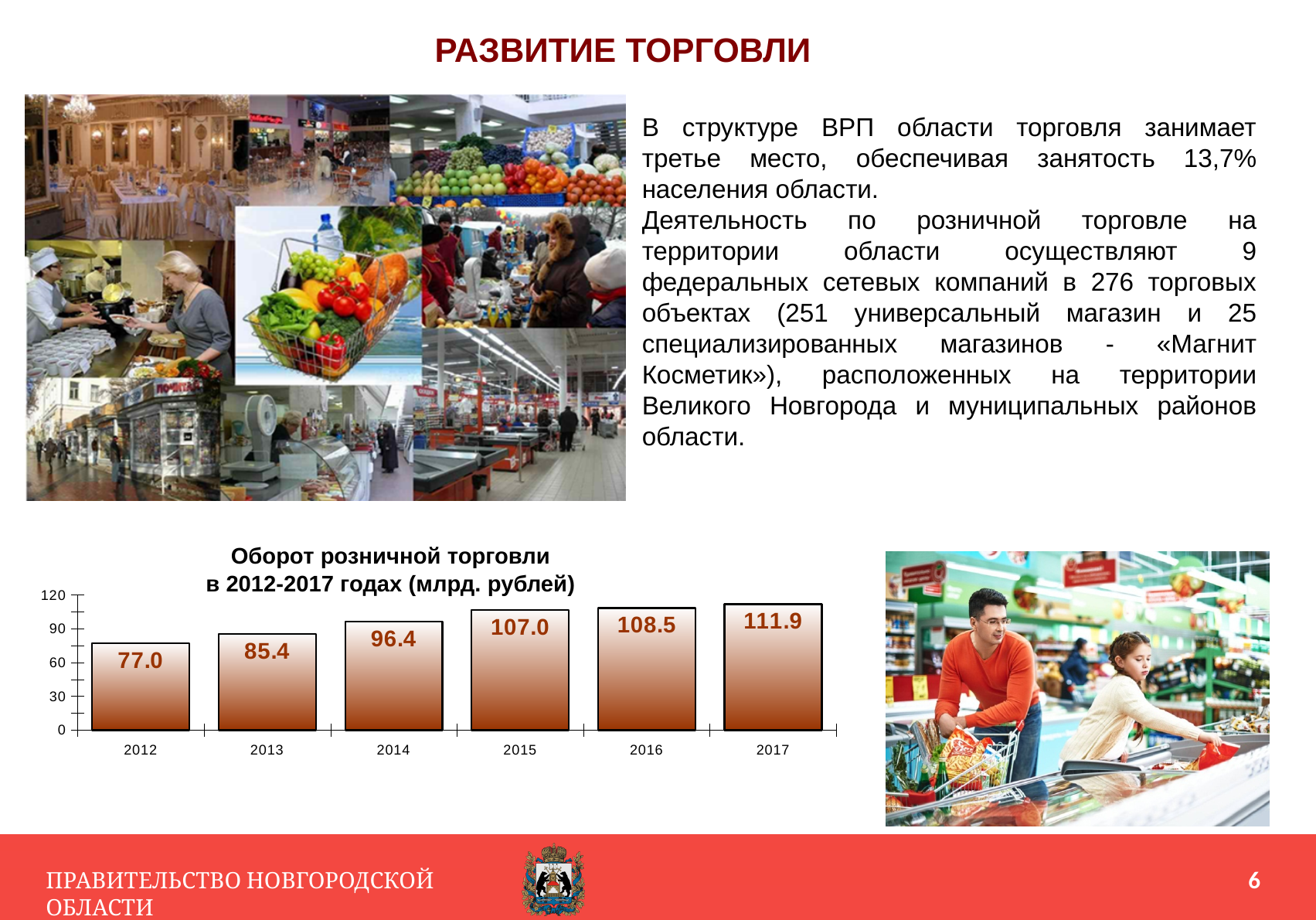
How many years are shown on the chart? 6 What is the retail trade turnover value for 2014? 96.4 What is the title of the chart? Оборот розничной торговли в 2012-2017 годах (млрд. рублей) What is the difference between the retail trade turnover in 2015 and in 2014? 10.6 Does the retail trade turnover rise or fall from 2012 to 2017? rise Which year has the highest retail trade turnover? 2017 Which year has the lowest retail trade turnover? 2012 What kind of chart is used to show retail trade turnover? bar chart Which year has a larger retail trade turnover, 2013 or 2015? 2015 What is the difference between the retail trade turnover in 2017 and in 2012? 34.9 What is the retail trade turnover value for 2017? 111.9 Is the retail trade turnover for 2012 greater or less than 90? less